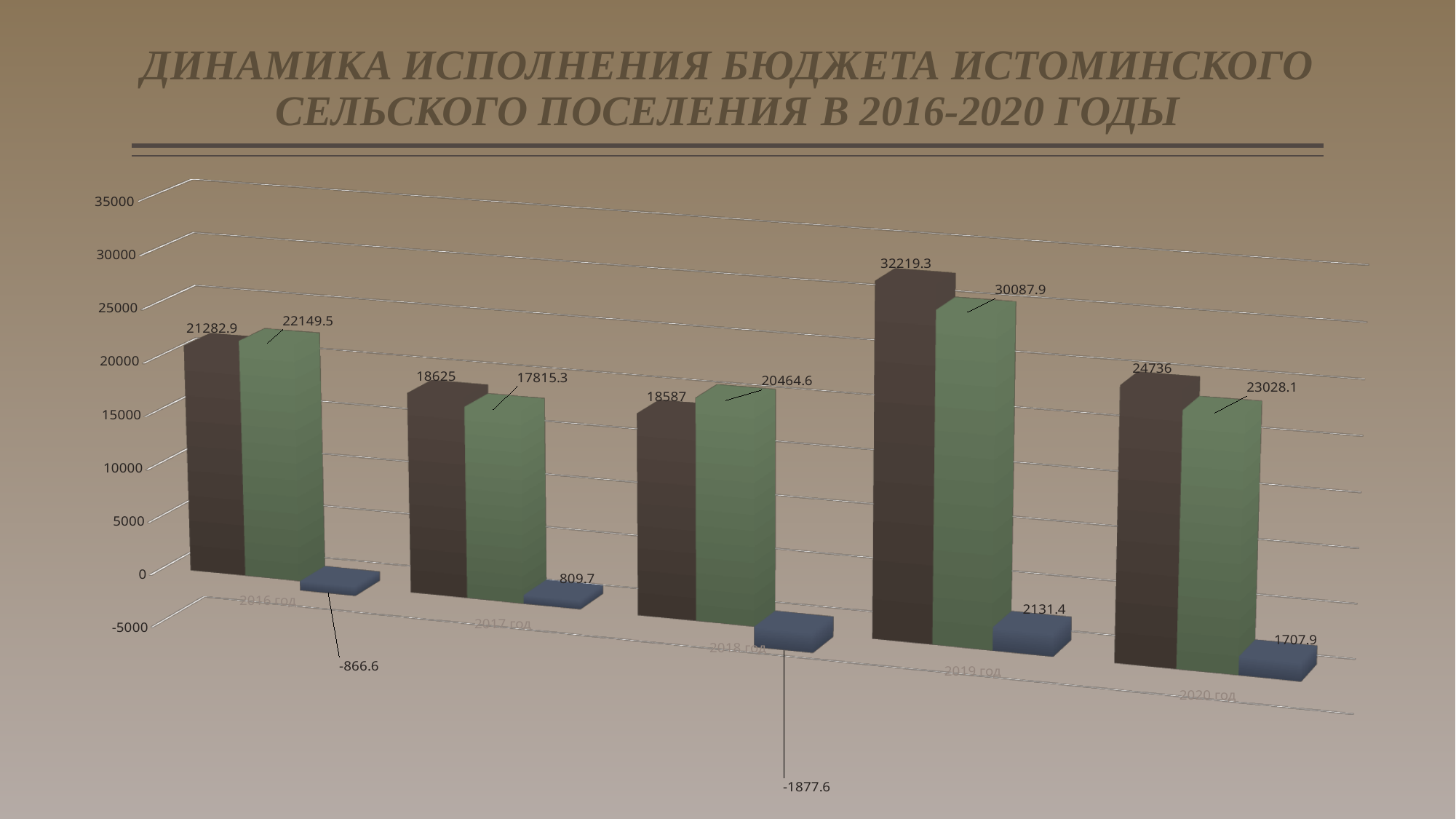
What is the value of the blue bar for 2020 год? 1707.9 What is the difference between the dark brown bar and the green bar for 2019 год? 2131.4 In which year is the green bar the lowest? 2017 год Which is larger for 2018 год, the dark brown bar or the green bar? the green bar What is the title of the chart on the slide? ДИНАМИКА ИСПОЛНЕНИЯ БЮДЖЕТА ИСТОМИНСКОГО СЕЛЬСКОГО ПОСЕЛЕНИЯ В 2016-2020 ГОДЫ Is the value of the dark brown bar for 2020 год greater or less than 20000? greater What is the value of the green bar for 2018 год? 20464.6 What is the value of the blue bar for 2016 год? -866.6 How many year categories are shown on the x axis of the chart? 5 What is the value of the dark brown bar for 2019 год? 32219.3 In which year is the dark brown bar the highest? 2019 год What type of chart is shown on the slide? bar chart